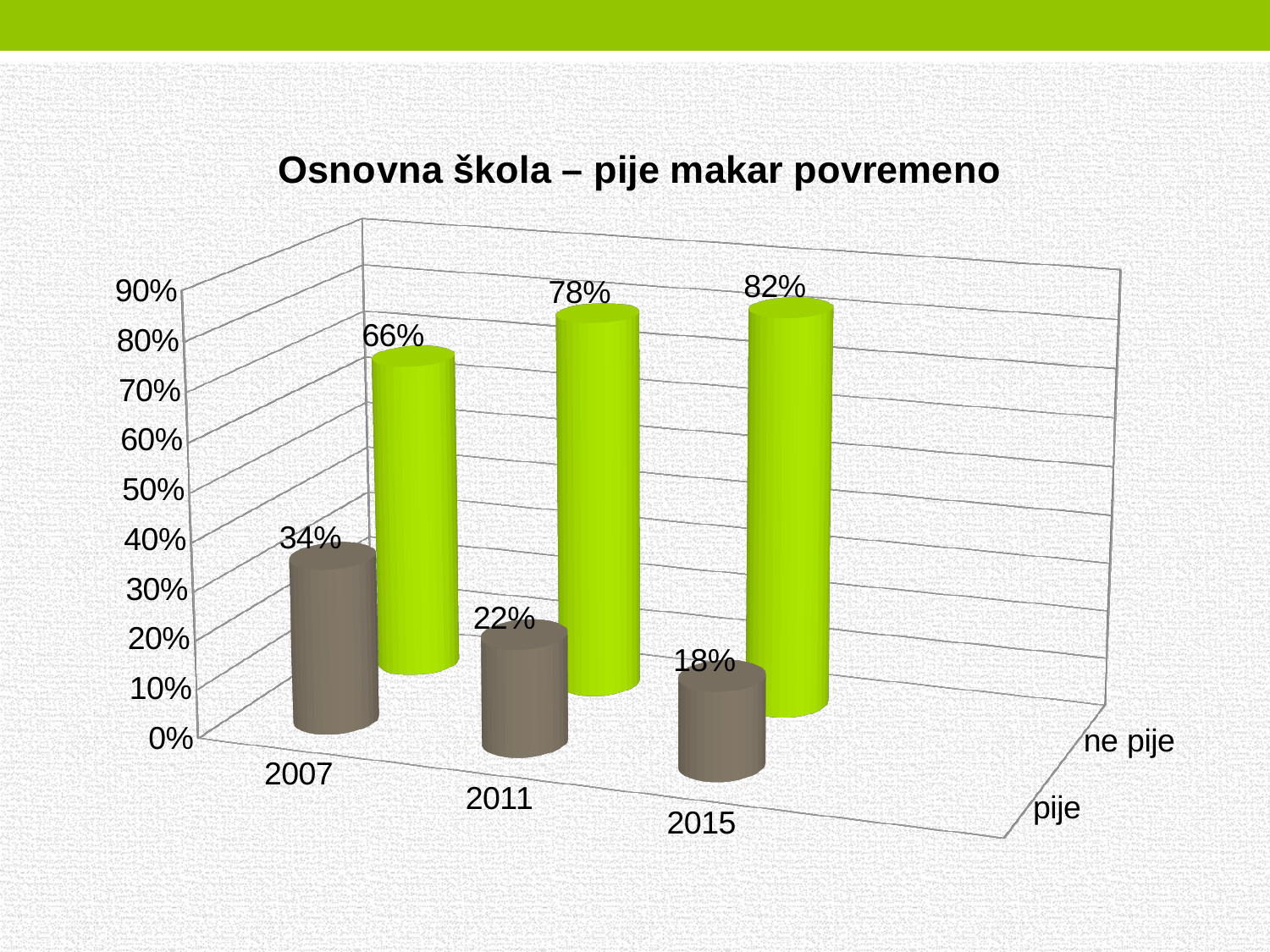
In which year is the 'pije' value lowest? 2015 What is the value for 'ne pije' in 2015? 82% How many series does the chart show? 2 How many years are shown on the x axis of the chart? 3 In which year is the 'ne pije' value highest? 2015 What type of chart is shown on the slide? bar chart Do the 'pije' values rise or fall from 2007 to 2015? fall What is the title of the chart? Osnovna škola – pije makar povremeno What is the difference between the 'ne pije' values for 2015 and 2007? 16% Which is larger in 2011: the 'pije' value or the 'ne pije' value? ne pije What is the value for 'pije' in 2007? 34% What is the value for 'pije' in 2011? 22%